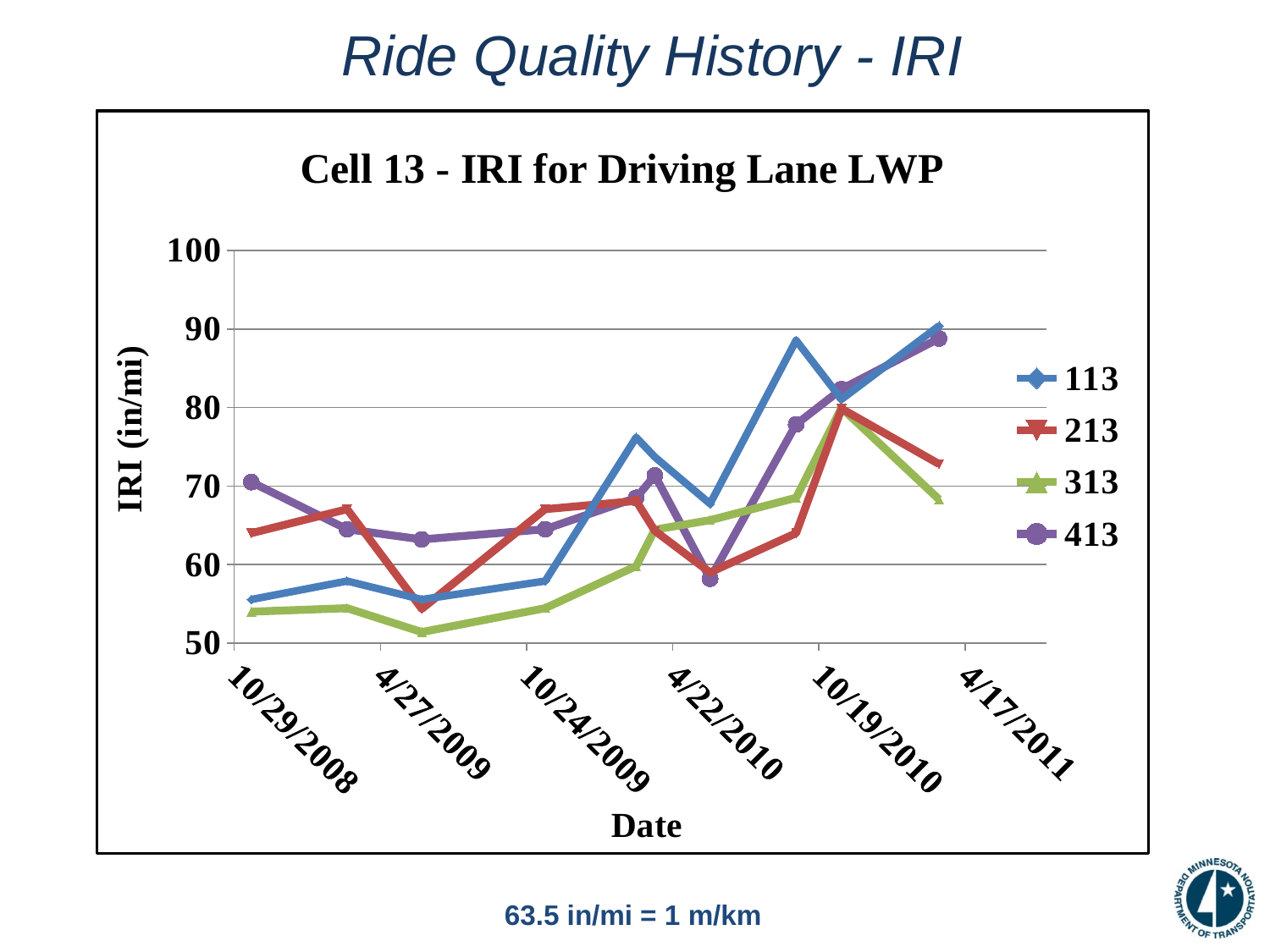
Does the value for series 313 rise or fall between 10/19/2010 and 4/17/2011? fall Is the value for series 313 at 4/27/2009 greater or less than 60? less What type of chart is shown on the slide? line chart At 4/17/2011, which is larger: the value for series 113 or series 313? 113 Which series has the lowest value at 4/17/2011? 313 Which series has the lowest value at 4/27/2009? 313 What is the title of the chart? Cell 13 - IRI for Driving Lane LWP Is the value for series 213 at 4/17/2011 greater or less than 70? greater Is the value for series 113 at 10/29/2008 greater or less than 60? less Which series has the highest value at 10/29/2008? 413 How many series does the legend list? 4 What is the label of the y axis? IRI (in/mi)